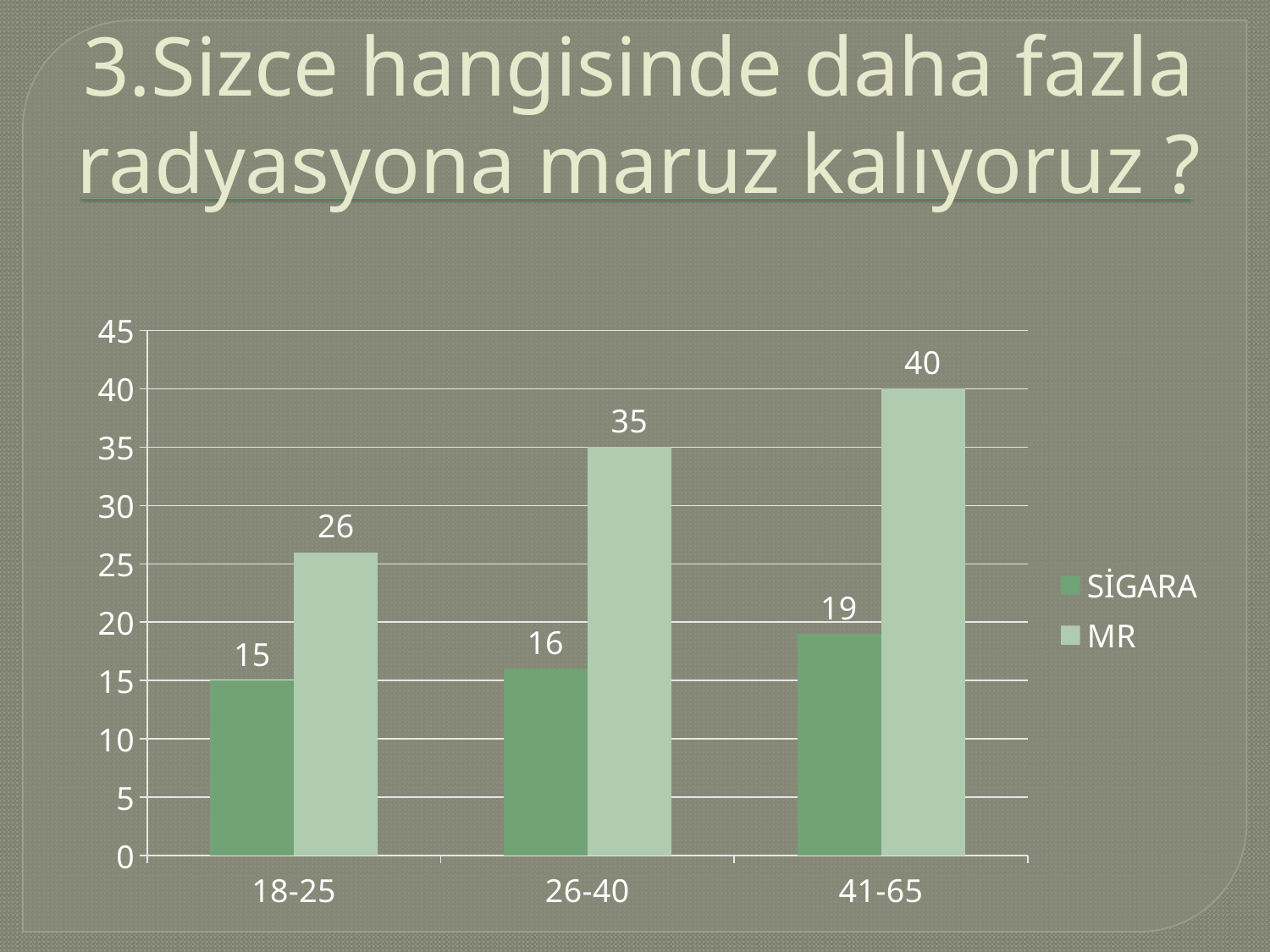
Do the MR values rise or fall from the 18-25 group to the 41-65 group? rise What is the value for SİGARA in the 18-25 age group? 15 Which age group has the lowest value for SİGARA? 18-25 How many age groups are shown on the x axis? 3 What is the difference between the MR and SİGARA values in the 26-40 age group? 19 What is the value for MR in the 26-40 age group? 35 Which age group has the highest value for MR? 41-65 Is the value for SİGARA in the 41-65 age group greater or less than 20? less What kind of chart is shown on the slide? bar chart How many series does the legend list? 2 Which is larger in the 18-25 age group, SİGARA or MR? MR What is the value for MR in the 41-65 age group? 40